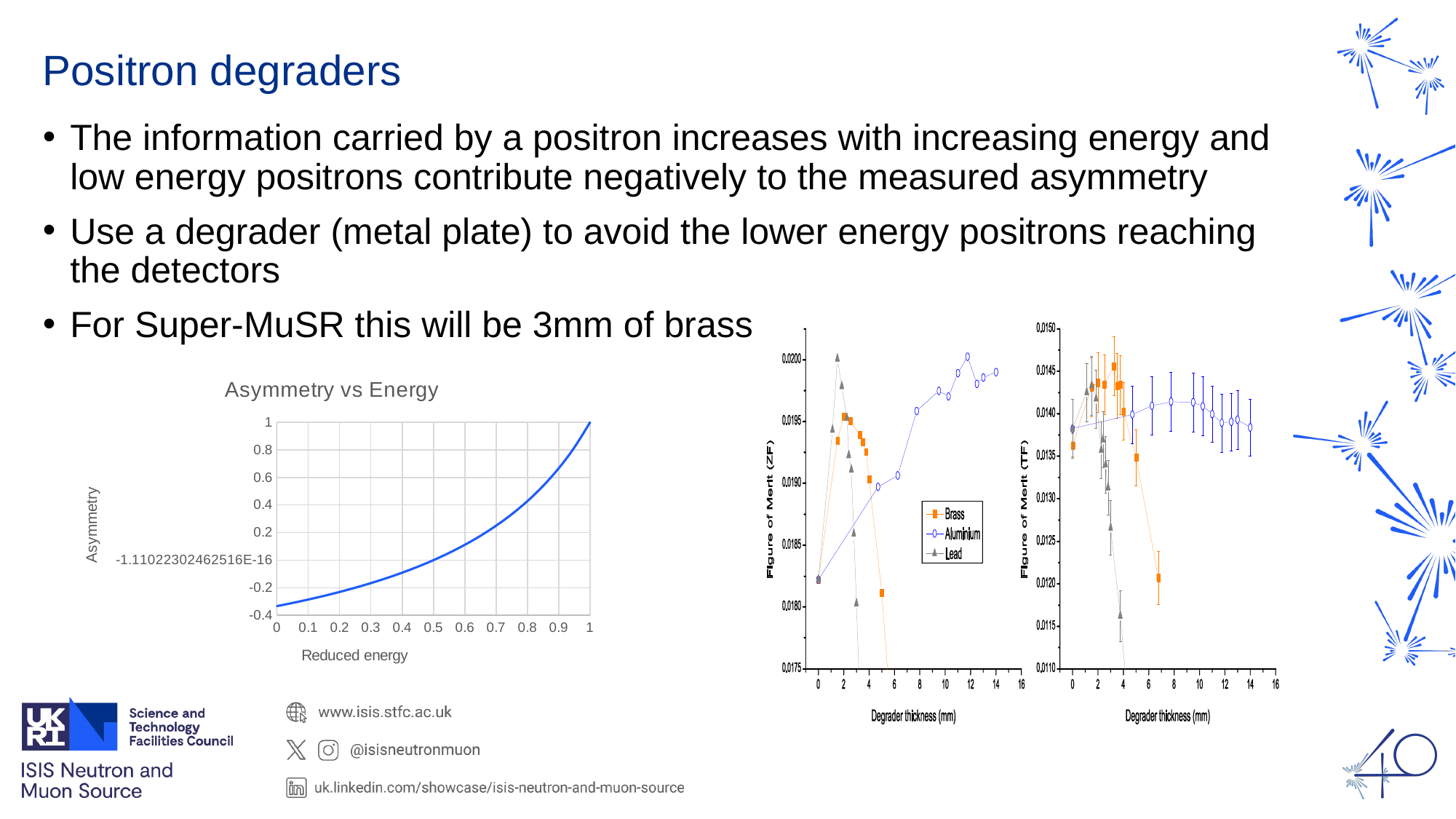
What kind of chart is the 'Asymmetry vs Energy' chart? line chart How many series does the legend of the 'Figure of Merit (ZF)' chart list? 3 In the 'Asymmetry vs Energy' chart, what is the asymmetry value at a reduced energy of 1? 1 In the 'Asymmetry vs Energy' chart, does asymmetry rise or fall as reduced energy increases? rise What is the x-axis label of the 'Asymmetry vs Energy' chart? Reduced energy In the 'Figure of Merit (ZF)' chart, is the Aluminium value at a degrader thickness of 14 mm greater or less than 0.0195? greater In the 'Figure of Merit (TF)' chart, is the Brass value at a degrader thickness of about 7 mm greater or less than 0.0125? less In the 'Figure of Merit (ZF)' chart, is the Lead value at a degrader thickness of 4 mm greater or less than 0.0185? less Which series are listed in the legend of the 'Figure of Merit (ZF)' chart? Brass, Aluminium, Lead